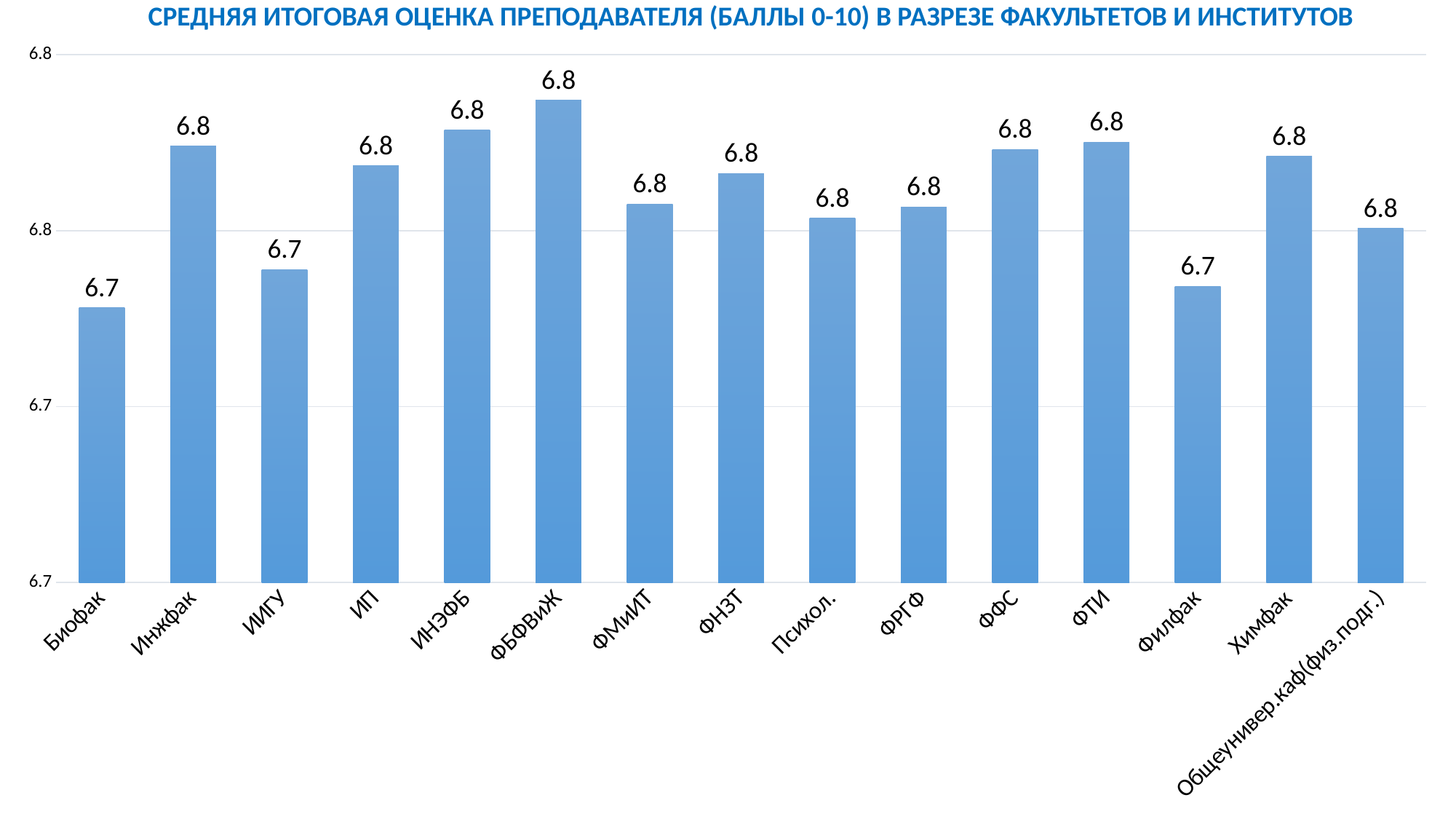
Which faculty or institute has the lowest bar? Биофак What type of chart is shown on the slide? bar chart What is the title of the chart? СРЕДНЯЯ ИТОГОВАЯ ОЦЕНКА ПРЕПОДАВАТЕЛЯ (БАЛЛЫ 0-10) В РАЗРЕЗЕ ФАКУЛЬТЕТОВ И ИНСТИТУТОВ Which has the larger value, Инжфак or ИИГУ? Инжфак How many faculties/institutes are shown on the x axis? 15 What is the average final teacher score for ИИГУ? 6.7 Which faculty or institute has the highest bar? ФБФВиЖ What is the average final teacher score for Биофак? 6.7 What is the average final teacher score for ФБФВиЖ? 6.8 What is the average final teacher score for Филфак? 6.7 What is the average final teacher score for Химфак? 6.8 What is the difference between the labelled values for ФБФВиЖ and Биофак? 0.1